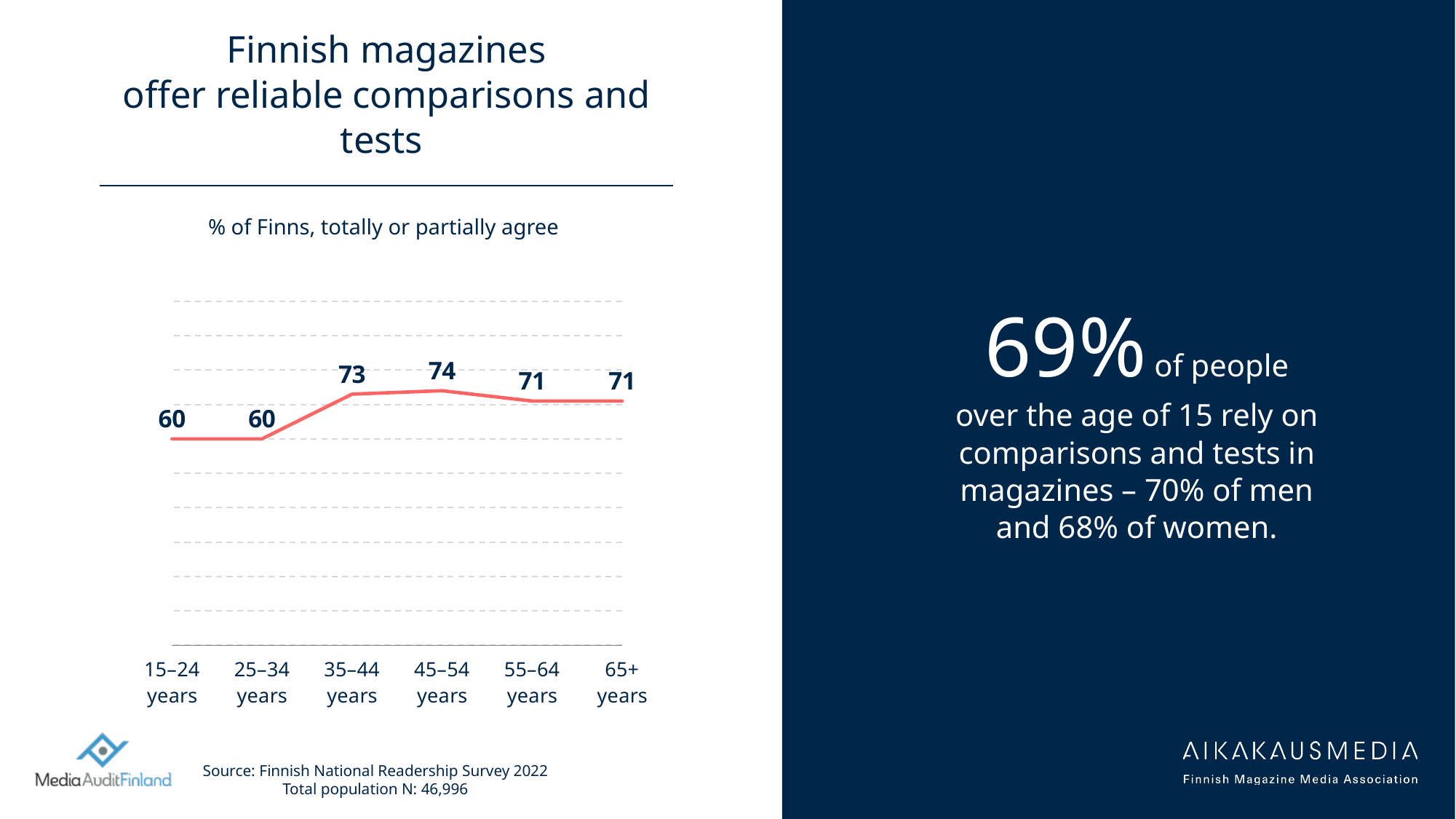
What is the value for the 65+ years age group? 71 Which age group has the highest value? 45–54 years What is the value for the 15–24 years age group? 60 Which is larger, the value for 35–44 years or the value for 15–24 years? 35–44 years What does the subtitle above the chart say the values represent? % of Finns, totally or partially agree What is the difference between the values for 35–44 years and 55–64 years? 2 Does the value rise or fall from 25–34 years to 35–44 years? Rise What is the title of the chart? Finnish magazines offer reliable comparisons and tests What kind of chart is shown on the slide? Line chart How many age groups are plotted on the chart? 6 What is the difference between the values for 45–54 years and 25–34 years? 14 What is the value for the 45–54 years age group? 74